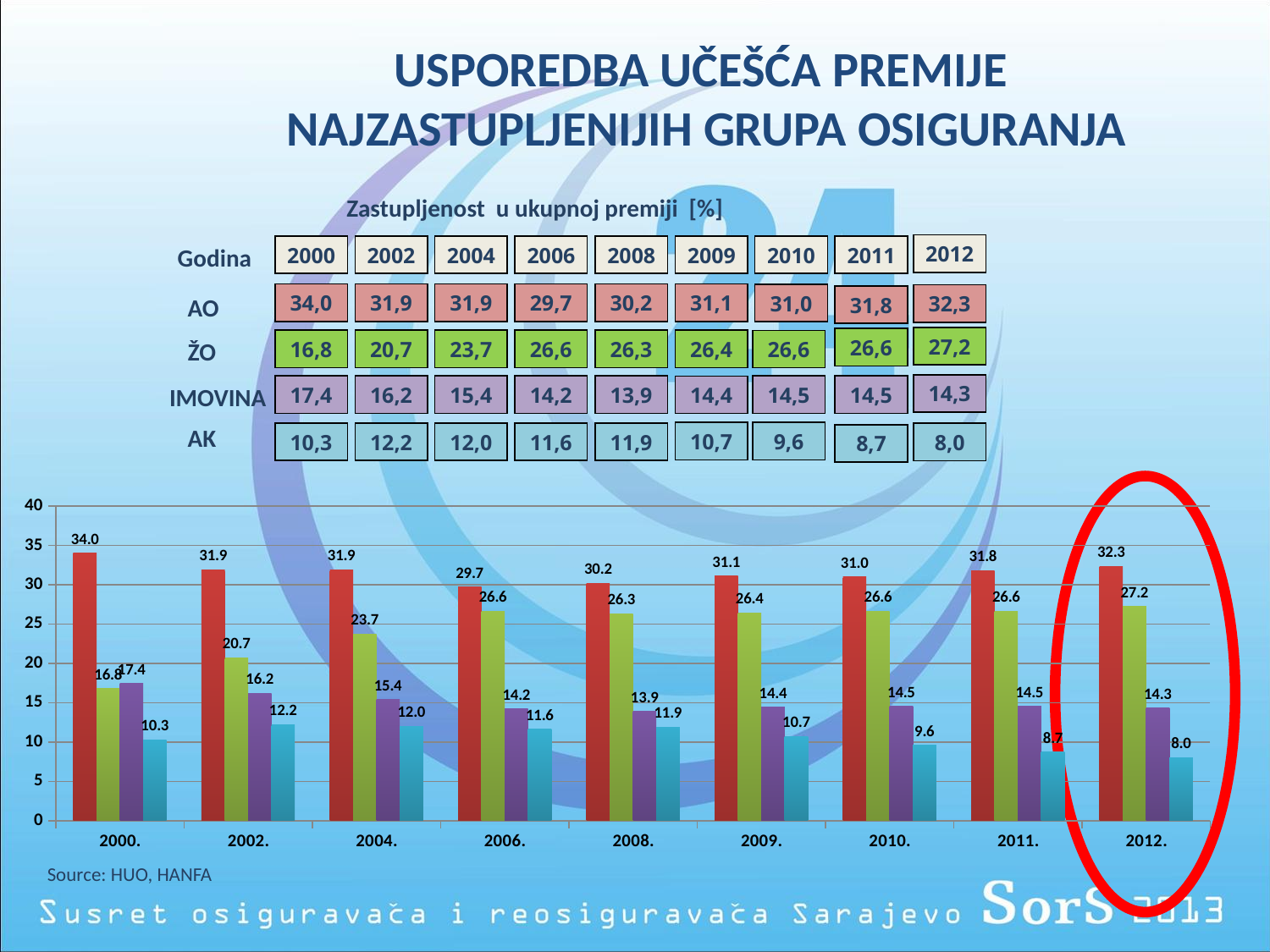
What is the value of the light blue (AK) bar for 2010 in the chart? 9.6 Which year's group of bars is circled in red on the chart? 2012 What kind of chart is shown on the slide? Bar chart What is the value of the red (AO) bar for 2012 in the chart? 32.3 By how much did the light blue (AK) bar fall from 2000 to 2012? 2.3 How many years are shown on the x axis of the chart? 9 What is the difference between the red (AO) bar and the green (ŽO) bar in 2012? 5.1 What is the value of the green (ŽO) bar for 2004 in the chart? 23.7 In which year is the red (AO) bar highest? 2000 Does the green (ŽO) series rise or fall from 2000 to 2012? Rises In 2000, which is larger: the green (ŽO) bar or the purple (IMOVINA) bar? IMOVINA (purple) In which year is the light blue (AK) bar lowest? 2012